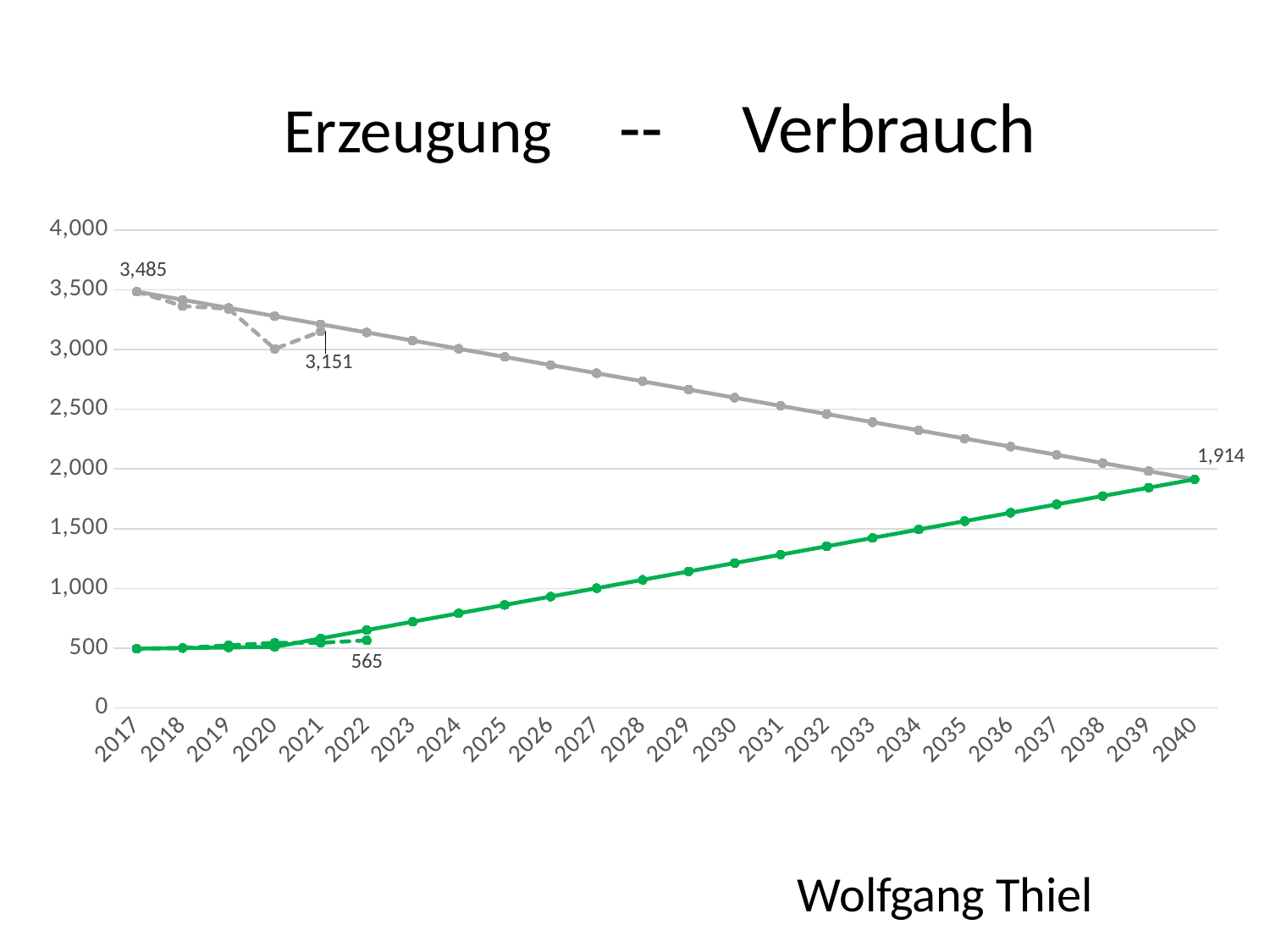
What value is labelled on the gray line at 2017? 3,485 Is the value of the gray line in 2035 greater or less than 2,500? less Is the value of the green line in 2030 greater or less than 1,000? greater In 2017, which line has the larger value, the gray line or the green line? gray line Does the gray line rise or fall from 2017 to 2040? fall What is the difference between the gray line's labelled 2017 value and its labelled 2040 value? 1,571 How many years are shown on the x axis? 24 What is the title of the chart? Erzeugung -- Verbrauch What value is labelled at 2040, where the gray and green lines meet? 1,914 What value is labelled on the green dashed line? 565 What kind of chart is shown on the slide? line chart Does the green line rise or fall from 2017 to 2040? rise